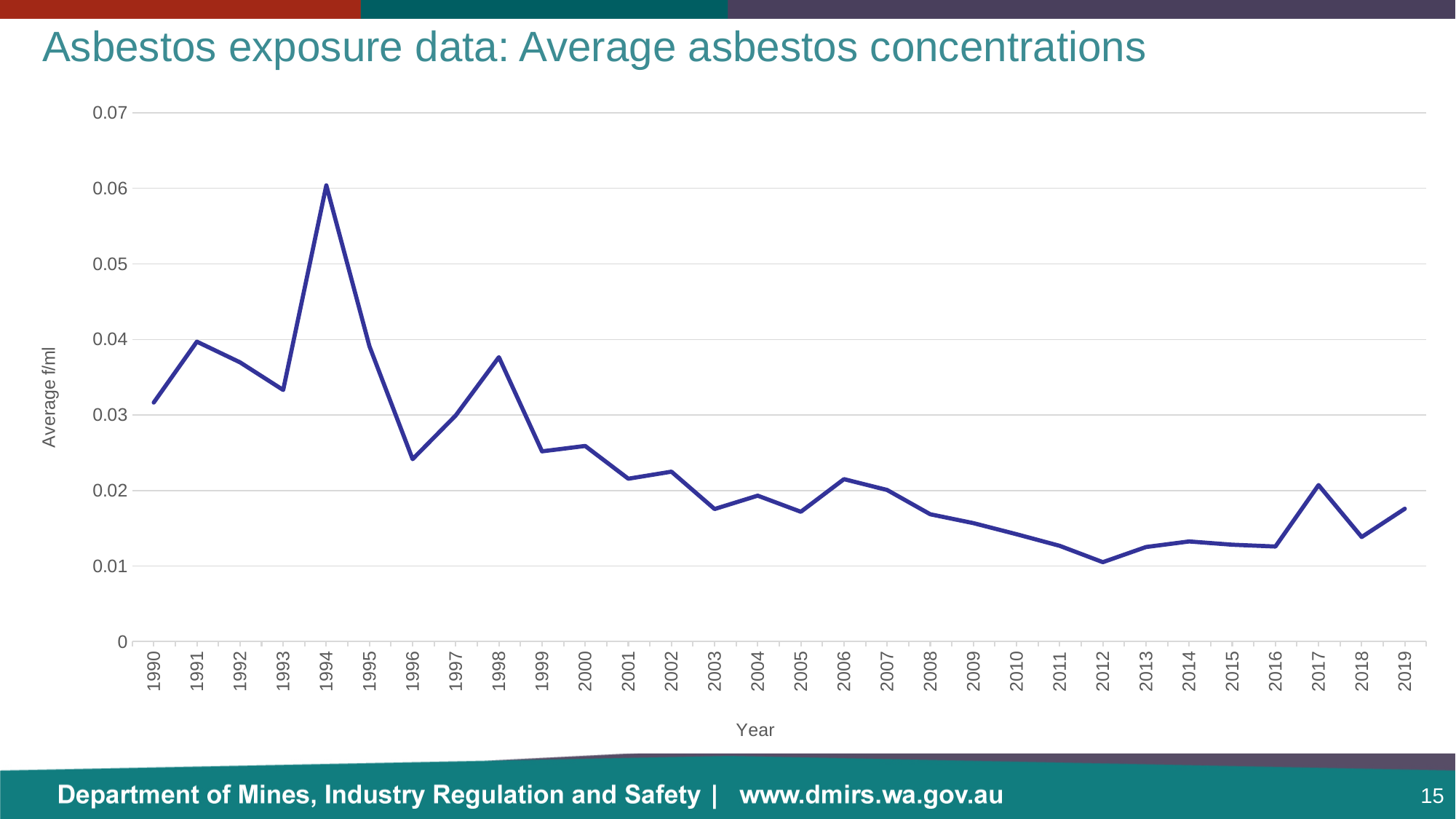
Is the value for 1994 greater or less than 0.05? greater Is the value for 2012 greater or less than 0.02? less Is the value for 1998 greater or less than 0.03? greater What is the label on the vertical axis? Average f/ml Which year has the highest average asbestos concentration? 1994 Which year has a higher average concentration, 1990 or 2019? 1990 How many years are plotted along the x axis? 30 What kind of chart is shown on the slide? line chart Which year has a higher average concentration, 1994 or 1998? 1994 Which year has the lowest average asbestos concentration? 2012 Overall, do the average asbestos concentrations rise or fall from 1990 to 2019? fall